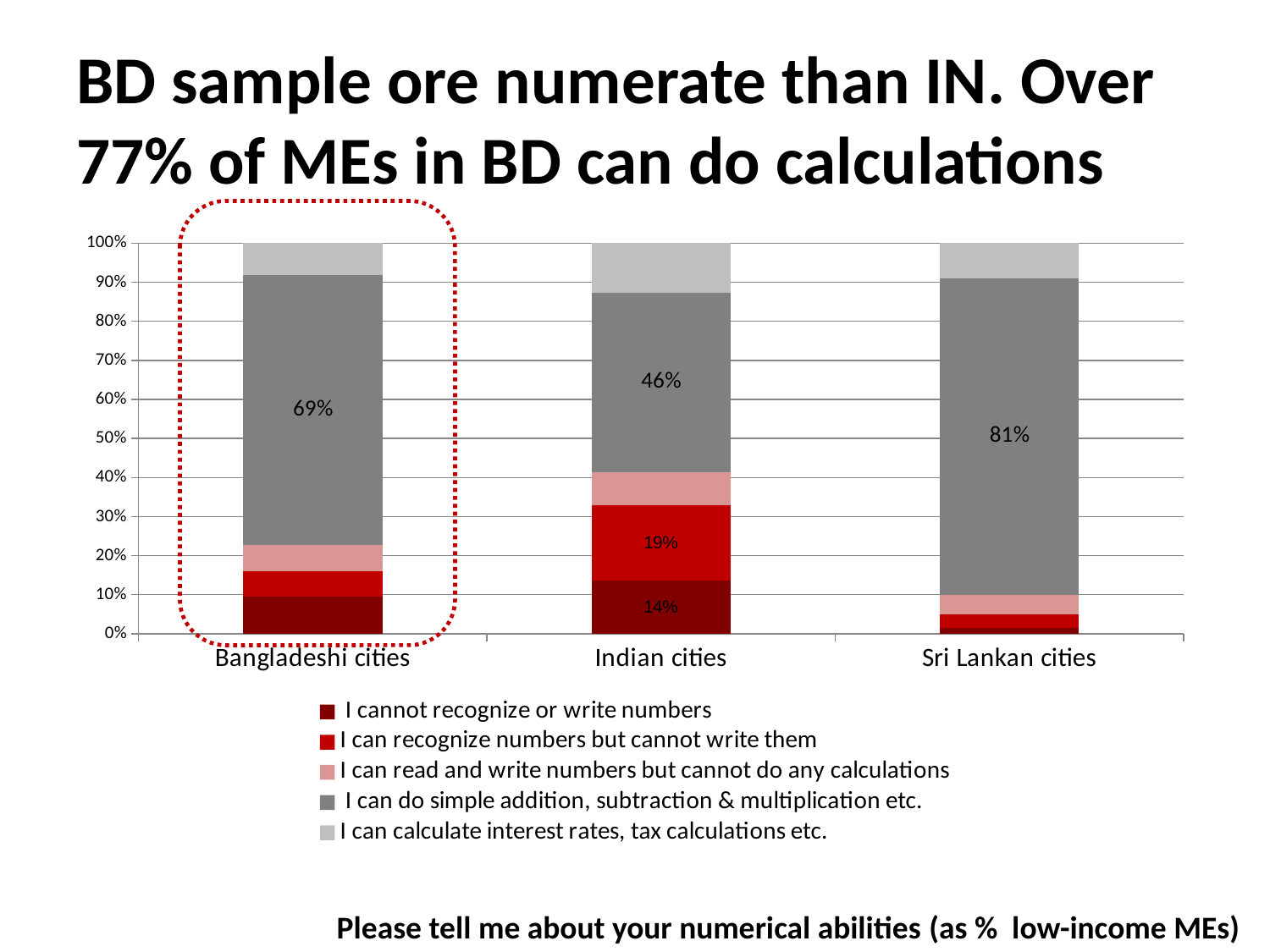
Which city group has the lowest share of MEs who can do simple addition, subtraction & multiplication etc.? Indian cities How many percentage points higher is the 'simple addition, subtraction & multiplication' share in Sri Lankan cities than in Bangladeshi cities? 12 percentage points How many city groups are shown on the x axis of the chart? 3 What percentage of low-income MEs in Bangladeshi cities say they can do simple addition, subtraction & multiplication etc.? 69% What percentage of low-income MEs in Indian cities say they cannot recognize or write numbers? 14% What percentage of low-income MEs in Indian cities say they can do simple addition, subtraction & multiplication etc.? 46% How many series does the chart legend list? 5 What kind of chart is shown on the slide? Stacked bar chart Is the share of MEs in Indian cities who can calculate interest rates, tax calculations etc. greater or less than 10%? greater What percentage of low-income MEs in Sri Lankan cities say they can do simple addition, subtraction & multiplication etc.? 81% Which city group has the highest share of MEs who can do simple addition, subtraction & multiplication etc.? Sri Lankan cities In Indian cities, which is larger: the share who can recognize numbers but cannot write them, or the share who cannot recognize or write numbers? I can recognize numbers but cannot write them (19%)